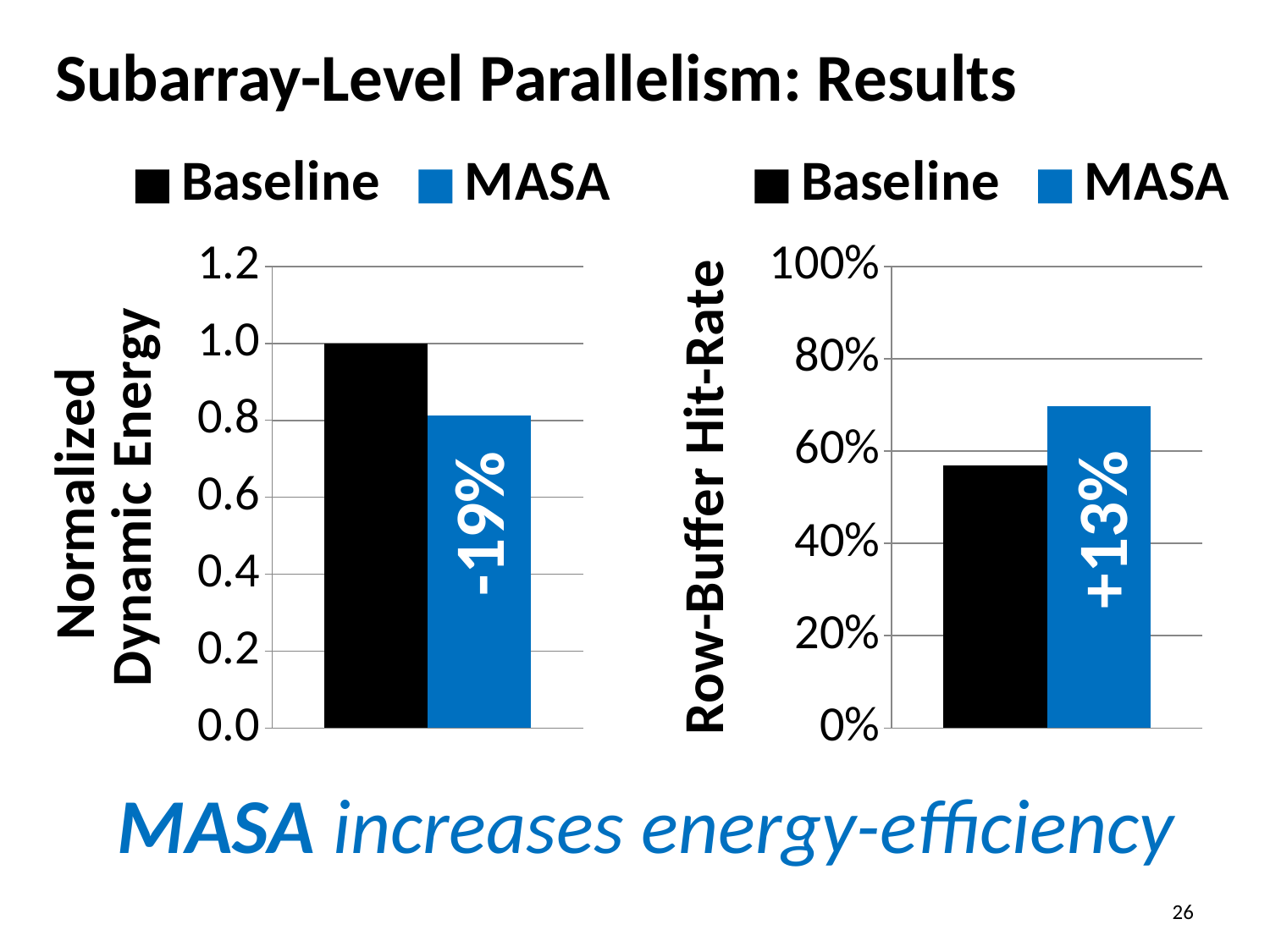
In the Normalized Dynamic Energy chart, is the value for MASA greater or less than 1.0? less In the Row-Buffer Hit-Rate chart, is the value for Baseline greater or less than 60%? less In the Row-Buffer Hit-Rate chart, what colour is the MASA bar? blue What kind of chart is the Row-Buffer Hit-Rate chart? bar chart In the Normalized Dynamic Energy chart, what is the value for Baseline? 1.0 How many series does the legend of the Normalized Dynamic Energy chart list? 2 In the Normalized Dynamic Energy chart, which series has the lower value? MASA In the Row-Buffer Hit-Rate chart, is Baseline or MASA larger? MASA In the Row-Buffer Hit-Rate chart, what percentage change is printed on the MASA bar? +13% In the Row-Buffer Hit-Rate chart, is the value for MASA greater or less than 60%? greater In the Normalized Dynamic Energy chart, what percentage change is printed on the MASA bar? -19% In the Row-Buffer Hit-Rate chart, which series has the higher value? MASA